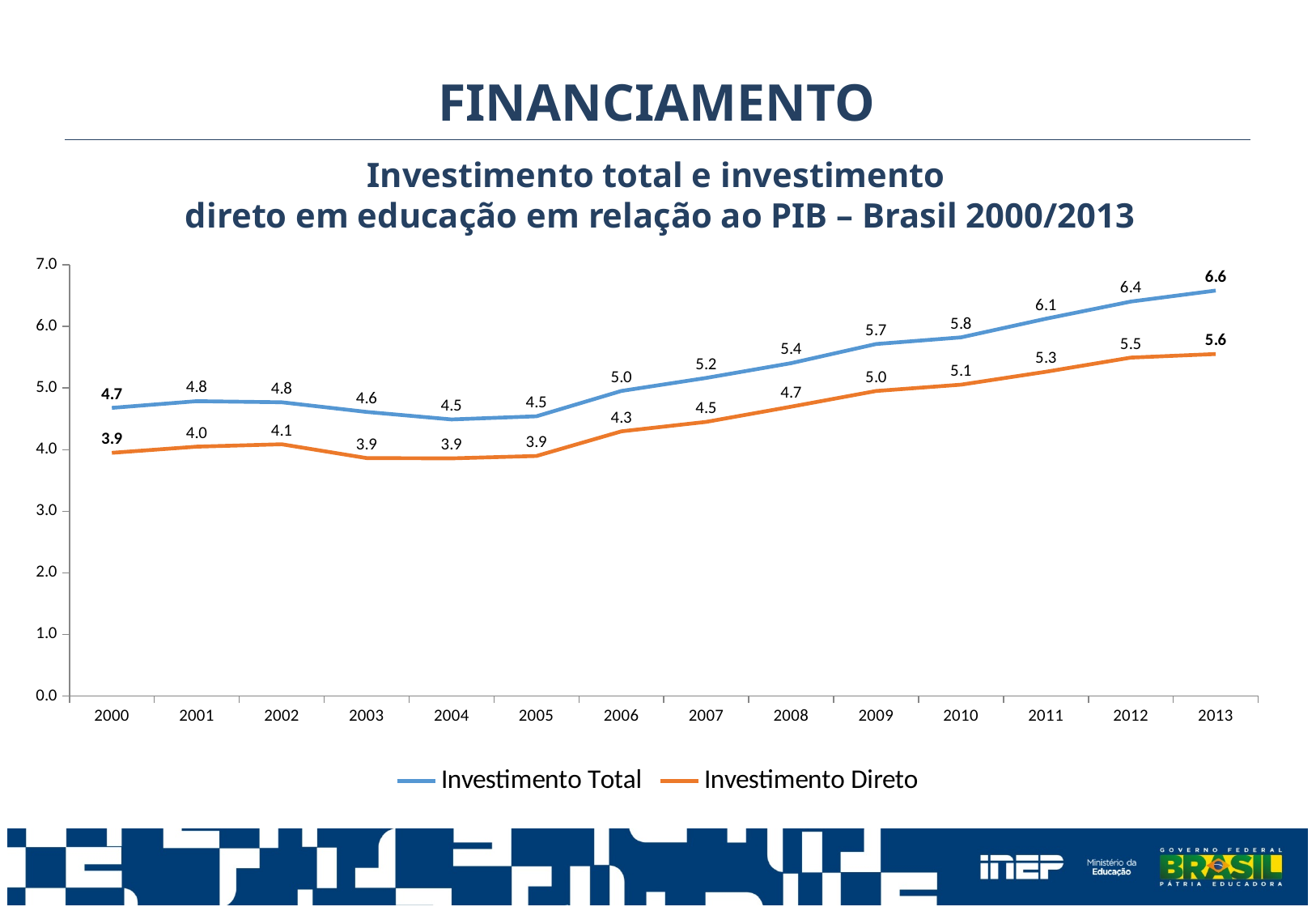
In which year is Investimento Direto highest? 2013 What is the difference between Investimento Total in 2013 and in 2000? 1.9 Which is larger in 2010: Investimento Total or Investimento Direto? Investimento Total What is the value of Investimento Total in 2013? 6.6 What is the value of Investimento Direto in 2009? 5.0 What kind of chart is shown on the slide? Line chart How many years are shown on the x axis? 14 What is the value of Investimento Direto in 2000? 3.9 What is the value of Investimento Total in 2004? 4.5 What is the difference between Investimento Total and Investimento Direto in 2013? 1.0 In which year is Investimento Total highest? 2013 How many series does the legend list? 2